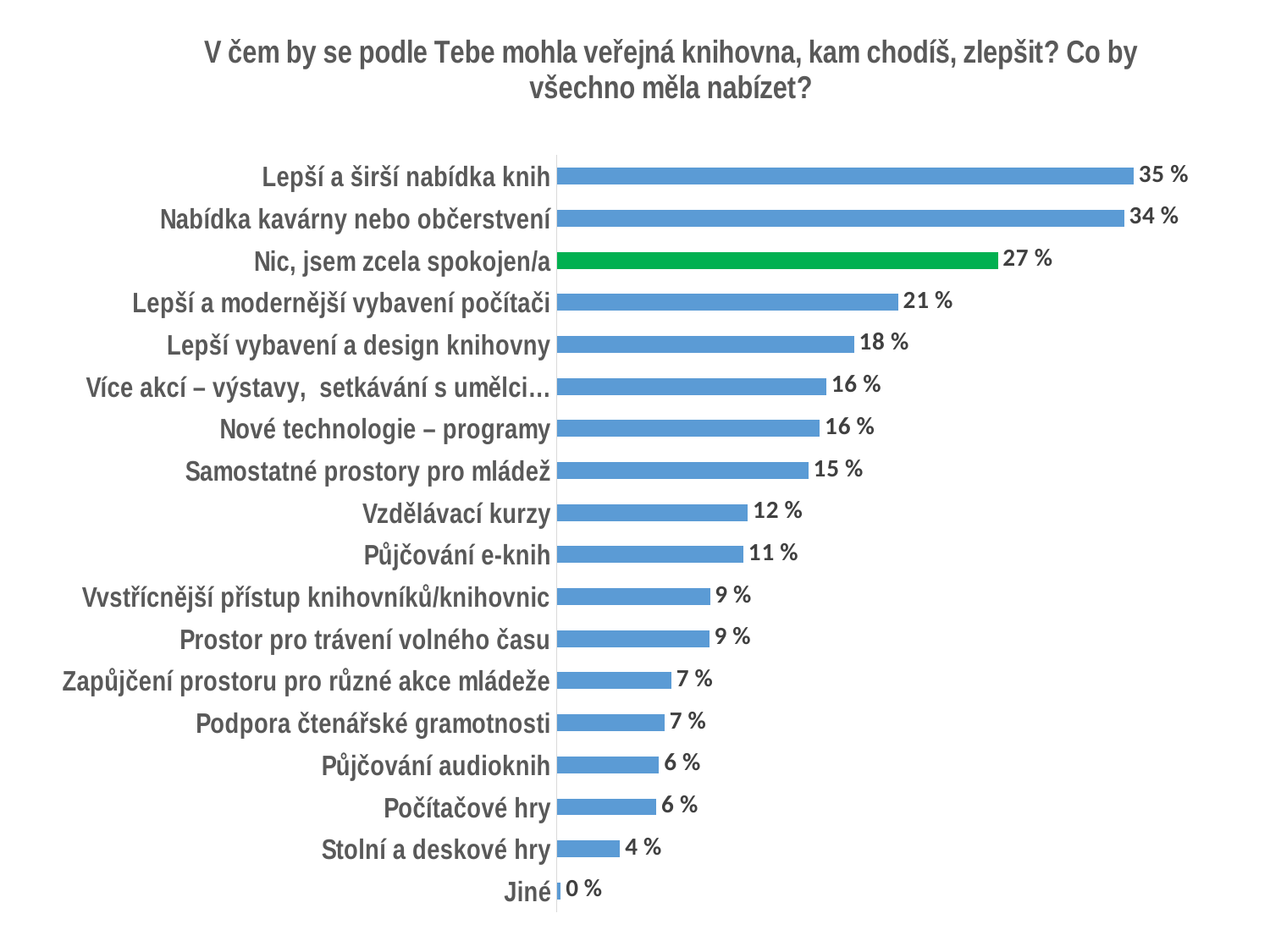
Which category has the highest value? Lepší a širší nabídka knih Which is larger: "Vzdělávací kurzy" or "Samostatné prostory pro mládež"? Samostatné prostory pro mládež Which category's bar is coloured green instead of blue? Nic, jsem zcela spokojen/a What kind of chart is shown on the slide? Bar chart What is the value for "Nic, jsem zcela spokojen/a"? 27 % How many categories are shown in the chart? 18 What is the difference between "Lepší a modernější vybavení počítači" and "Lepší vybavení a design knihovny"? 3 % What is the value for "Stolní a deskové hry"? 4 % Which category has the lowest value? Jiné What is the value for "Lepší a širší nabídka knih"? 35 % What is the value for "Půjčování e-knih"? 11 % What is the difference between "Nabídka kavárny nebo občerstvení" and "Nic, jsem zcela spokojen/a"? 7 %